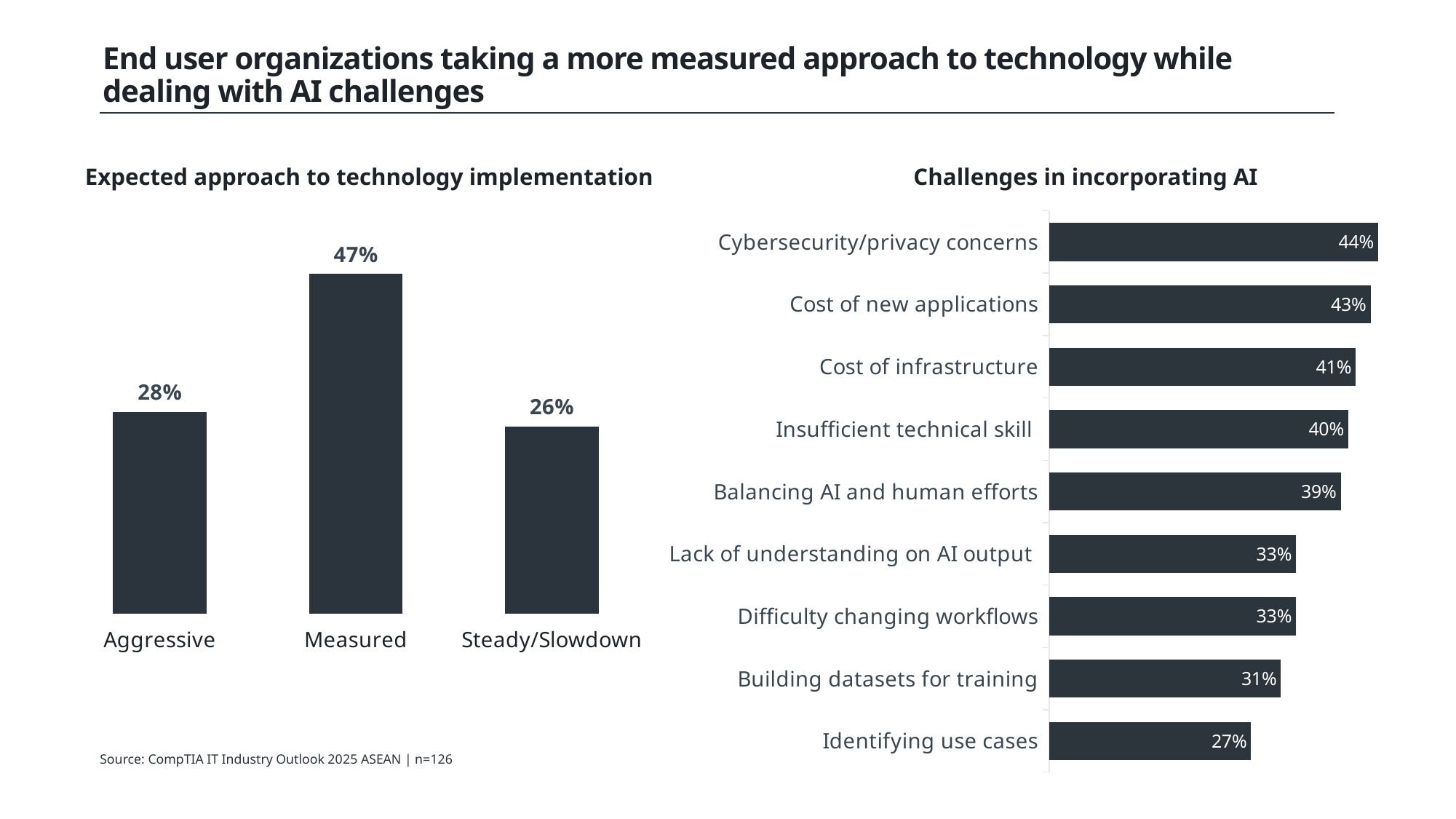
In the 'Expected approach to technology implementation' chart, how many categories are shown? 3 In the 'Challenges in incorporating AI' chart, which challenge has the highest value? Cybersecurity/privacy concerns In the 'Challenges in incorporating AI' chart, what is the value for Cost of infrastructure? 41% In the 'Challenges in incorporating AI' chart, how many challenges are listed? 9 In the 'Challenges in incorporating AI' chart, which is larger: Insufficient technical skill or Building datasets for training? Insufficient technical skill In the 'Expected approach to technology implementation' chart, which category has the lowest value? Steady/Slowdown In the 'Challenges in incorporating AI' chart, which challenge has the lowest value? Identifying use cases In the 'Expected approach to technology implementation' chart, what is the difference between Measured and Aggressive? 19 percentage points What kind of chart is 'Challenges in incorporating AI'? Bar chart What is the source cited at the bottom of the slide? CompTIA IT Industry Outlook 2025 ASEAN | n=126 In the 'Challenges in incorporating AI' chart, what is the difference between Cybersecurity/privacy concerns and Identifying use cases? 17 percentage points In the 'Expected approach to technology implementation' chart, what is the value for Measured? 47%